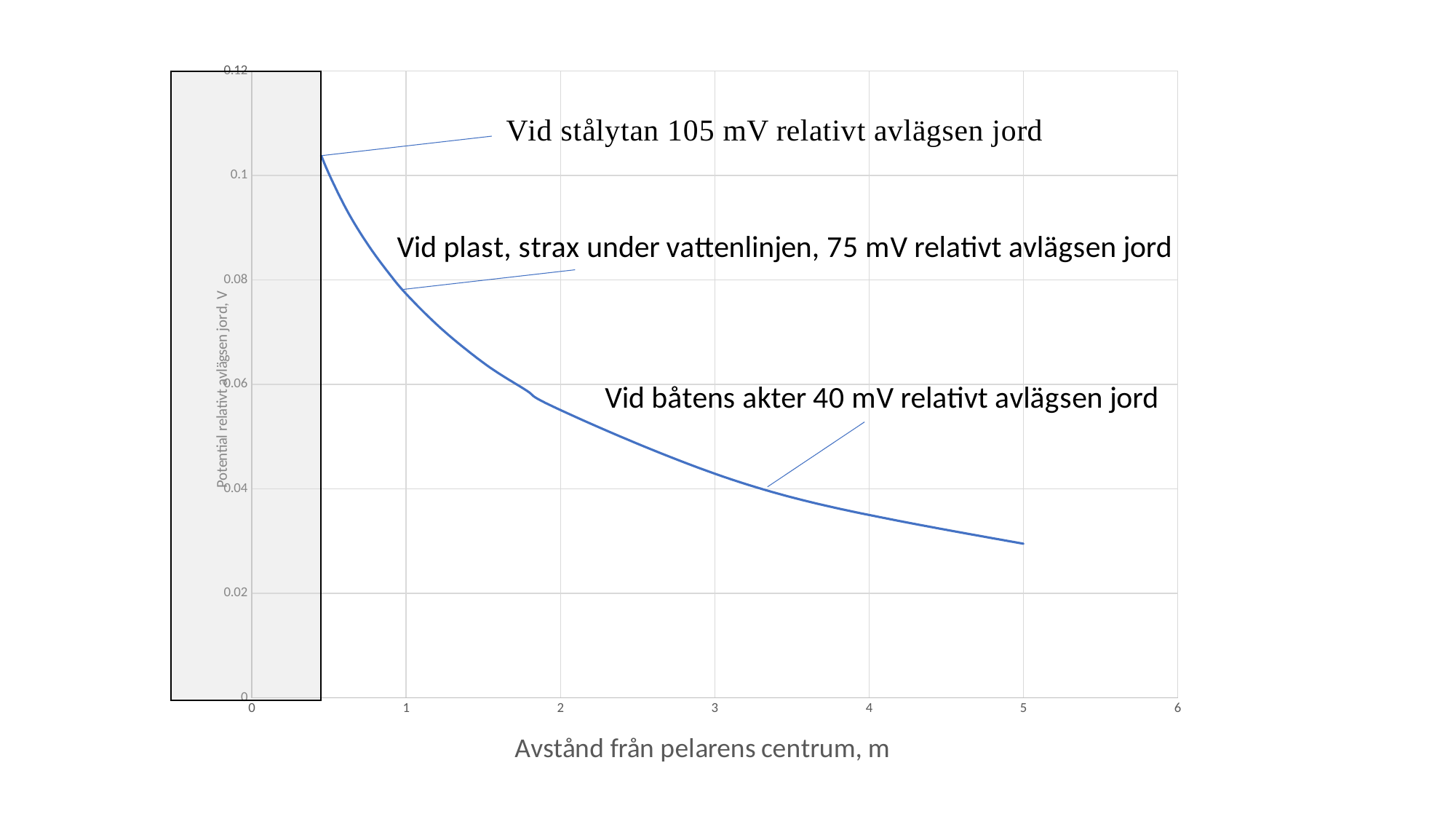
According to the annotation, what is the potential at the plastic just below the waterline relative to remote earth? 75 mV What is the label of the x axis? Avstånd från pelarens centrum, m What is the label of the y axis? Potential relativt avlägsen jord, V Which annotated potential is larger: at the steel surface or at the boat's stern? at the steel surface What kind of chart is shown on the slide? line chart Does the potential rise or fall as the distance from the pillar centre increases? fall According to the annotation, what is the potential at the boat's stern (båtens akter) relative to remote earth? 40 mV What is the difference between the annotated potential at the steel surface and at the boat's stern? 65 mV Is the potential at a distance of 3 m greater or less than 0.06 V? less Is the potential at a distance of 5 m greater or less than 0.04 V? less Is the potential at a distance of 1 m greater or less than 0.06 V? greater According to the annotation, what is the potential at the steel surface (stålytan) relative to remote earth? 105 mV